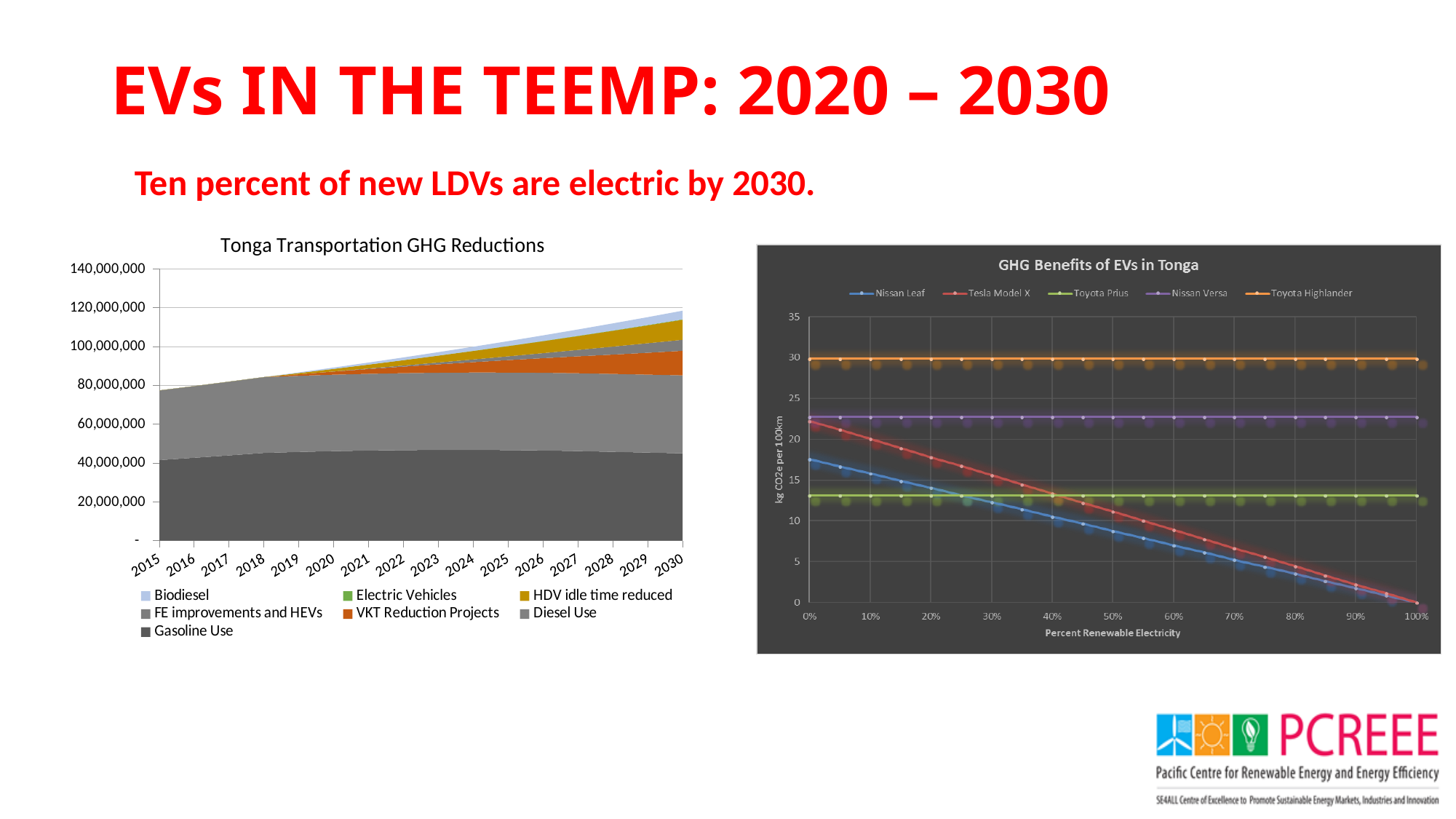
What type of chart is the 'Tonga Transportation GHG Reductions' chart? stacked area chart What type of chart is the 'GHG Benefits of EVs in Tonga' chart? line chart In the 'GHG Benefits of EVs in Tonga' chart, which series has the lowest value at 0% renewable electricity? Toyota Prius In the 'GHG Benefits of EVs in Tonga' chart, which is larger at 0% renewable electricity: Tesla Model X or Nissan Leaf? Tesla Model X In the 'GHG Benefits of EVs in Tonga' chart, is the value for Toyota Highlander at 0% greater or less than 25? greater In the 'GHG Benefits of EVs in Tonga' chart, does the Tesla Model X line rise or fall as percent renewable electricity increases? fall In the 'GHG Benefits of EVs in Tonga' chart, which series has the highest value at 0% renewable electricity? Toyota Highlander In the 'Tonga Transportation GHG Reductions' chart, does the total stacked value rise or fall from 2015 to 2030? rise In the 'Tonga Transportation GHG Reductions' chart, is the total stacked value in 2030 greater or less than 100,000,000? greater How many series does the legend of the 'Tonga Transportation GHG Reductions' chart list? 7 How many years are shown on the x axis of the 'Tonga Transportation GHG Reductions' chart? 16 How many series does the legend of the 'GHG Benefits of EVs in Tonga' chart list? 5